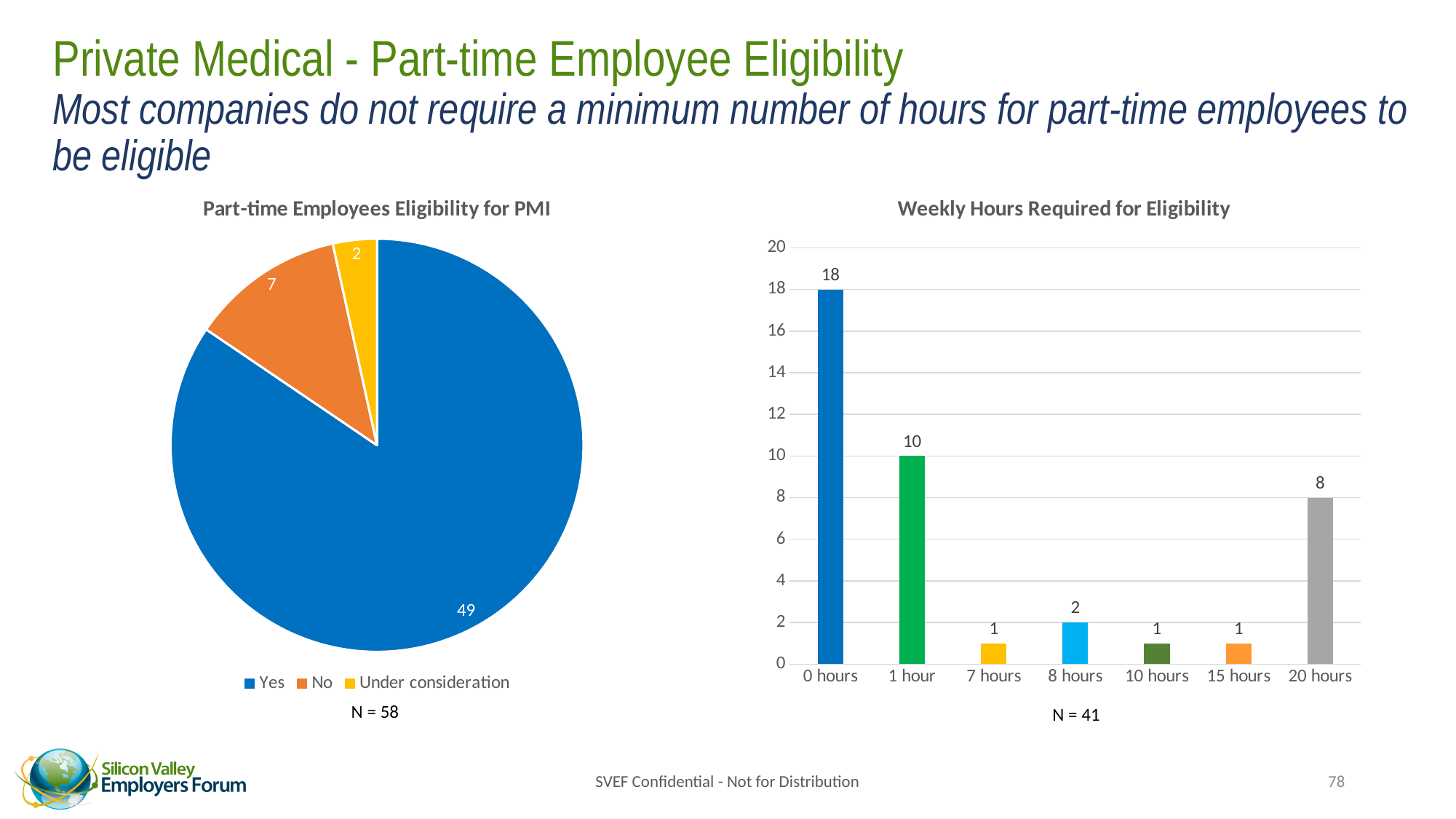
In the 'Part-time Employees Eligibility for PMI' chart, what is the difference between the 'Yes' and 'No' values? 42 In the 'Part-time Employees Eligibility for PMI' chart, what is the value for 'Yes'? 49 In the 'Weekly Hours Required for Eligibility' chart, what is the value for '20 hours'? 8 In the 'Part-time Employees Eligibility for PMI' chart, what kind of chart is shown? Pie chart In the 'Part-time Employees Eligibility for PMI' chart, what is the value for 'Under consideration'? 2 In the 'Weekly Hours Required for Eligibility' chart, which is larger, the value for '8 hours' or the value for '20 hours'? 20 hours In the 'Weekly Hours Required for Eligibility' chart, how many categories are shown on the x axis? 7 In the 'Weekly Hours Required for Eligibility' chart, which category has the highest value? 0 hours In the 'Weekly Hours Required for Eligibility' chart, what is the value for '1 hour'? 10 In the 'Part-time Employees Eligibility for PMI' chart, how many categories does the legend list? 3 In the 'Weekly Hours Required for Eligibility' chart, what kind of chart is shown? Bar chart In the 'Weekly Hours Required for Eligibility' chart, what is the difference between the values for '0 hours' and '1 hour'? 8